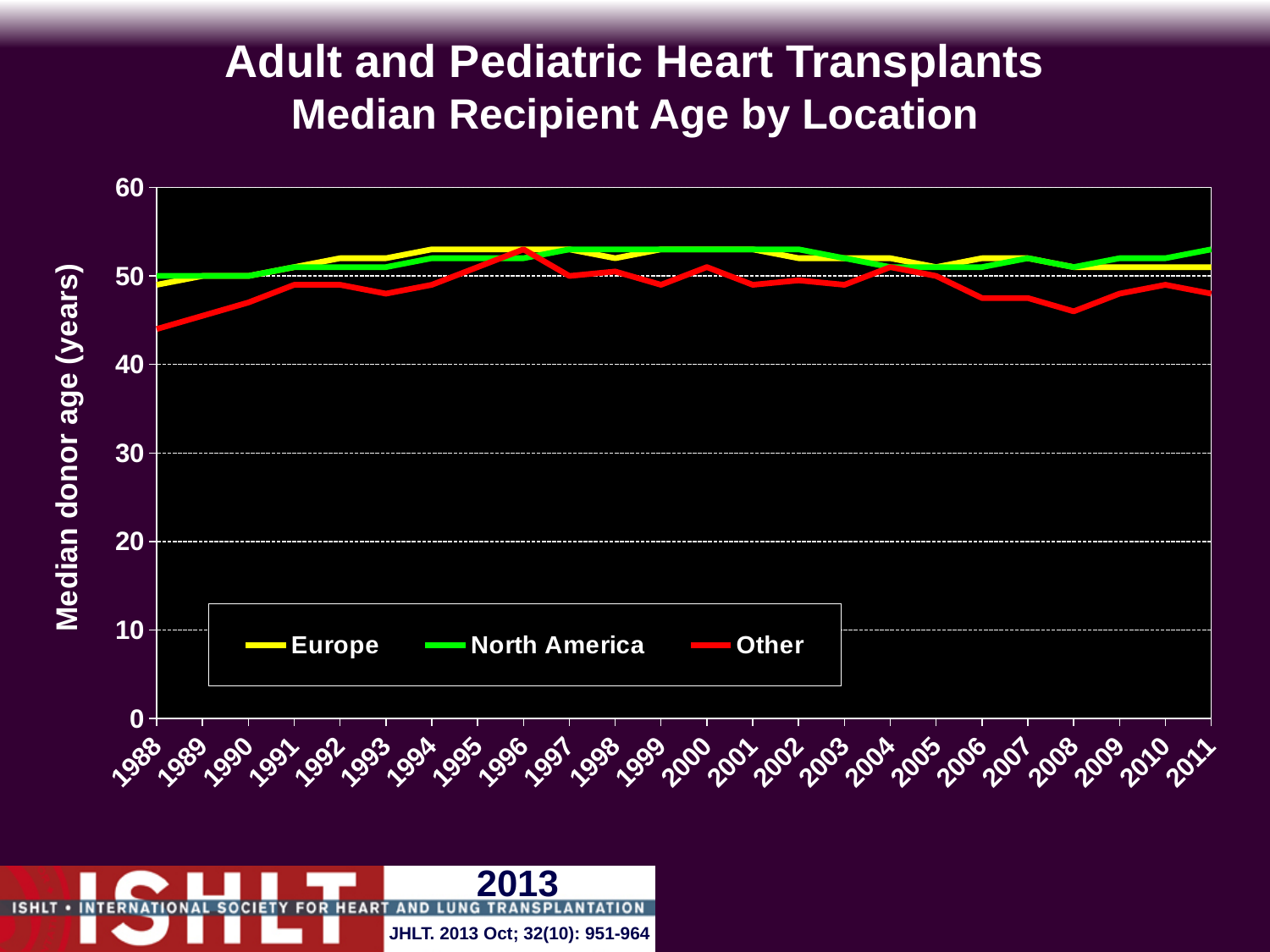
Which series has the lowest value in 1988? Other How many years are plotted along the x axis? 24 What is the label on the y axis? Median donor age (years) In 2008, which is larger, the value for Europe or the value for Other? Europe Is the value for North America in 1994 greater or less than 50? greater How many series does the legend list? 3 Is the value for Other in 1988 greater or less than 50? less What kind of chart is shown on the slide? line chart Is the value for Other in 1988 greater or less than 40? greater What colour is the line for North America? green Does the Other series rise or fall from 1988 to 1991? rise